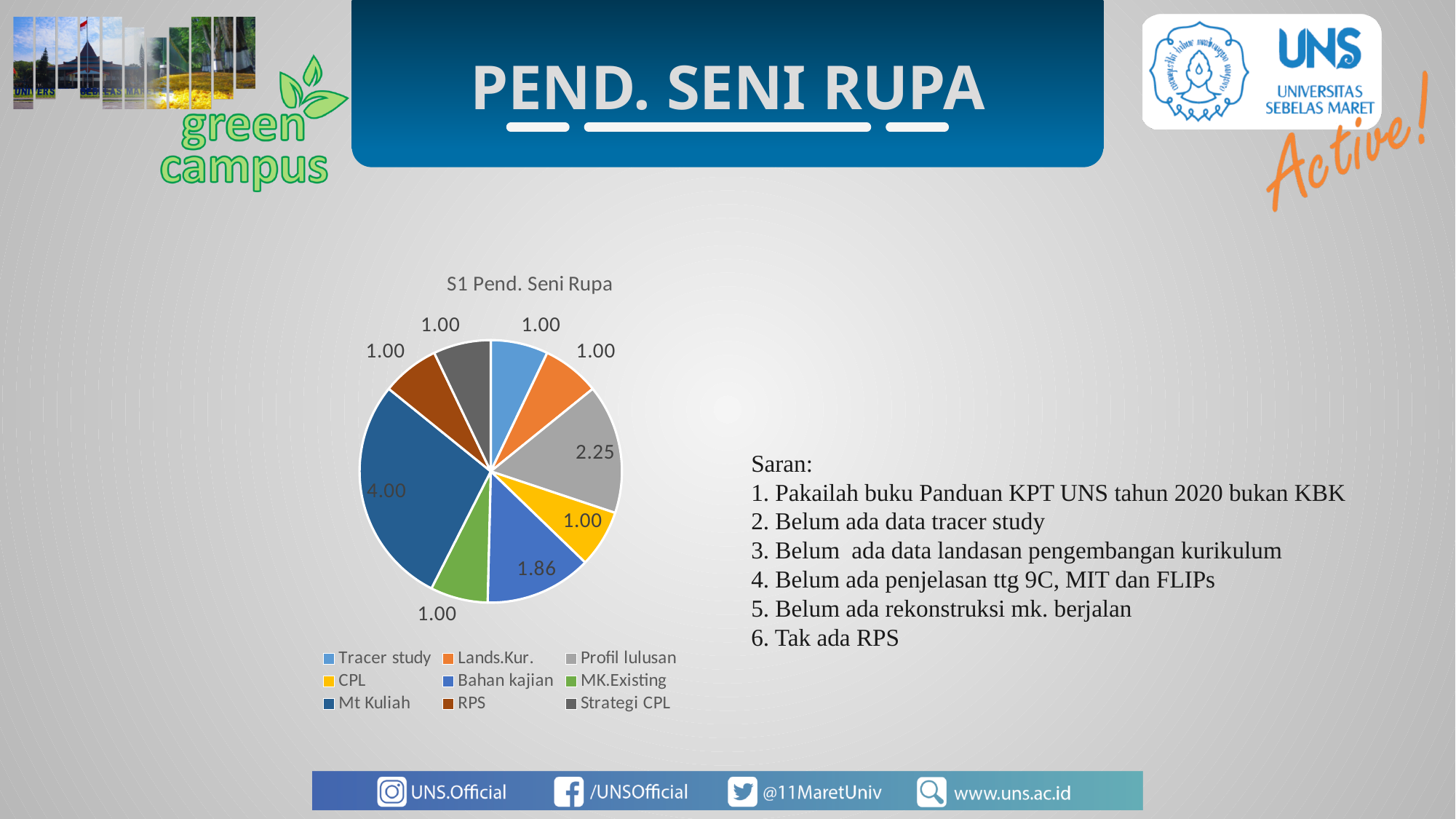
What colour is the Mt Kuliah slice? dark blue What is the value for Bahan kajian? 1.86 What is the value for Profil lulusan? 2.25 Which category has the largest slice? Mt Kuliah What is the value for CPL? 1.00 What is the title of the chart? S1 Pend. Seni Rupa Which is larger, the value for Bahan kajian or the value for Profil lulusan? Profil lulusan What is the difference between the values for Mt Kuliah and Profil lulusan? 1.75 How many slices does the pie chart have? 9 What is the difference between the values for Profil lulusan and Bahan kajian? 0.39 What type of chart is shown on the slide? pie chart What is the value for Mt Kuliah? 4.00